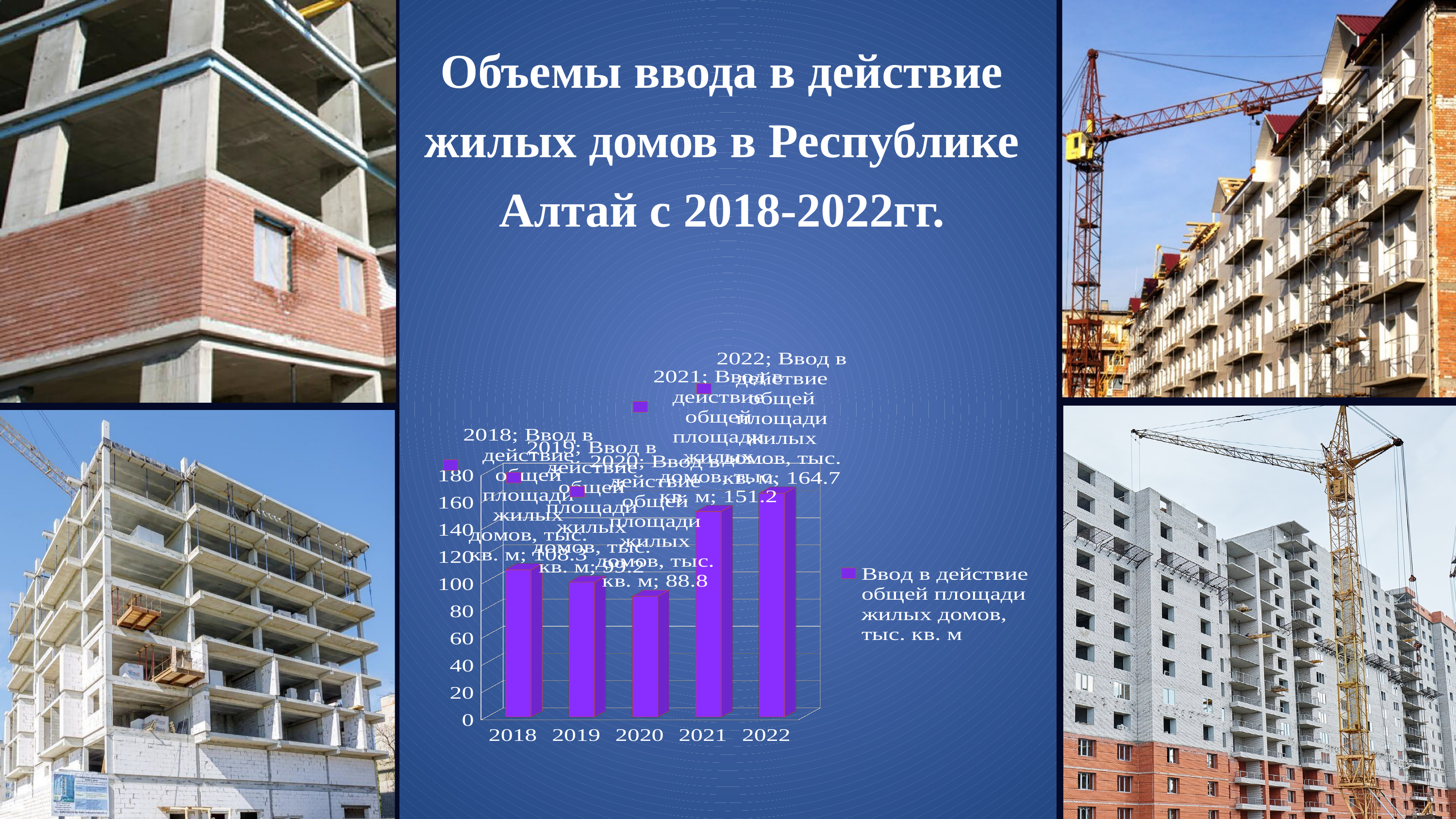
Is the value for 2021 greater or less than 140? greater How many years are shown on the x axis? 5 Which year has the lowest value? 2020 Which is larger, the value for 2019 or the value for 2021? 2021 What is the difference between the values for 2022 and 2021? 13.5 What is the value for 2022? 164.7 Do the values rise or fall from 2020 to 2022? rise What is the value for 2018? 108.3 What is the value for 2020? 88.8 How many series does the legend list? 1 Which year has the highest value? 2022 What type of chart is shown on the slide? bar chart